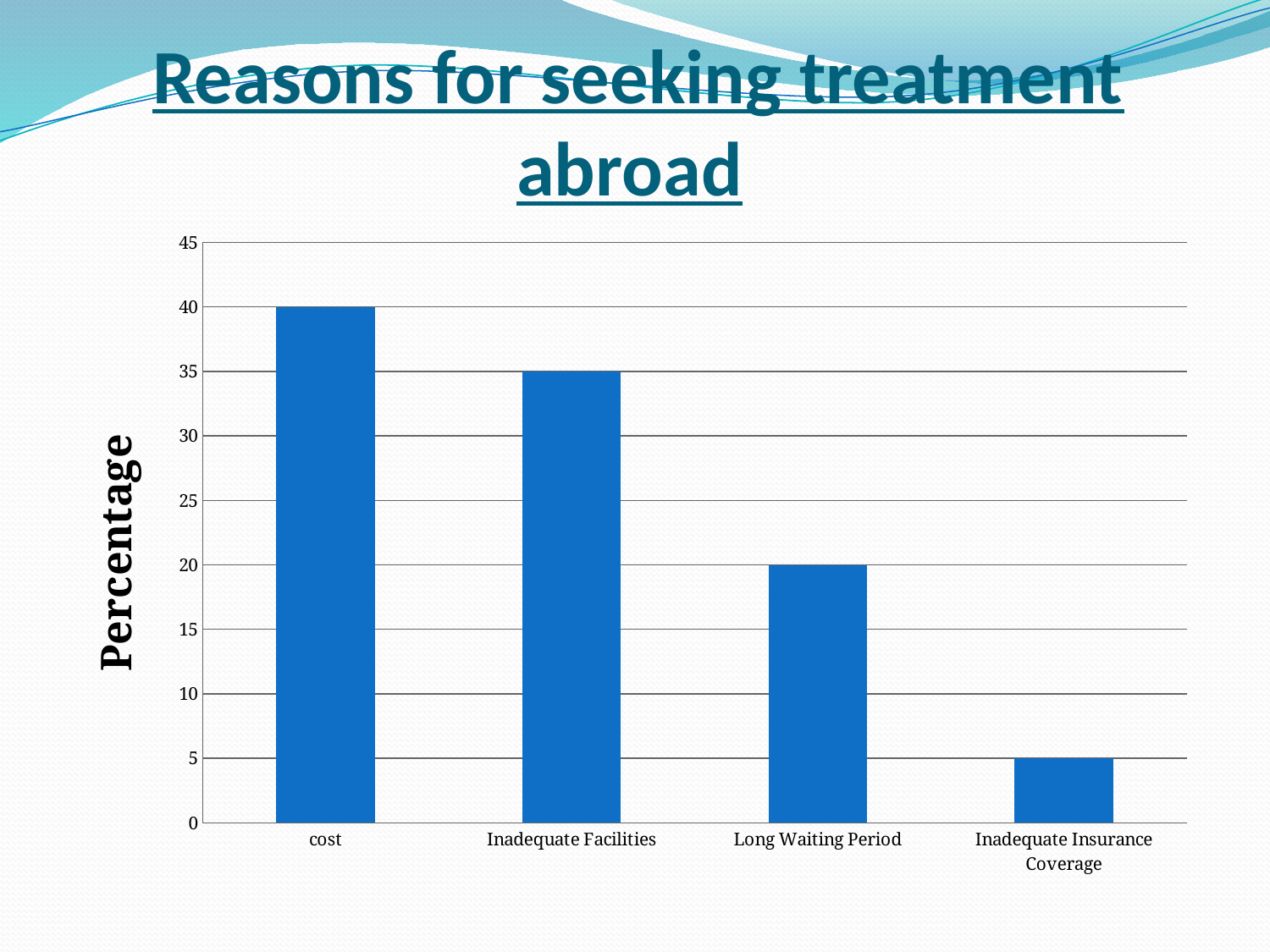
How many reasons are shown on the x axis? 4 What is the percentage for Inadequate Facilities? 35 What type of chart is shown on the slide? bar chart What is the percentage for Inadequate Insurance Coverage? 5 Which reason has the lowest percentage? Inadequate Insurance Coverage Which is larger, the percentage for Inadequate Facilities or for Long Waiting Period? Inadequate Facilities Do the values rise or fall from left to right along the x axis? fall What is the percentage for Long Waiting Period? 20 What is the label on the vertical axis? Percentage What is the difference in percentage between cost and Long Waiting Period? 20 What is the percentage for cost? 40 Which reason has the highest percentage? cost